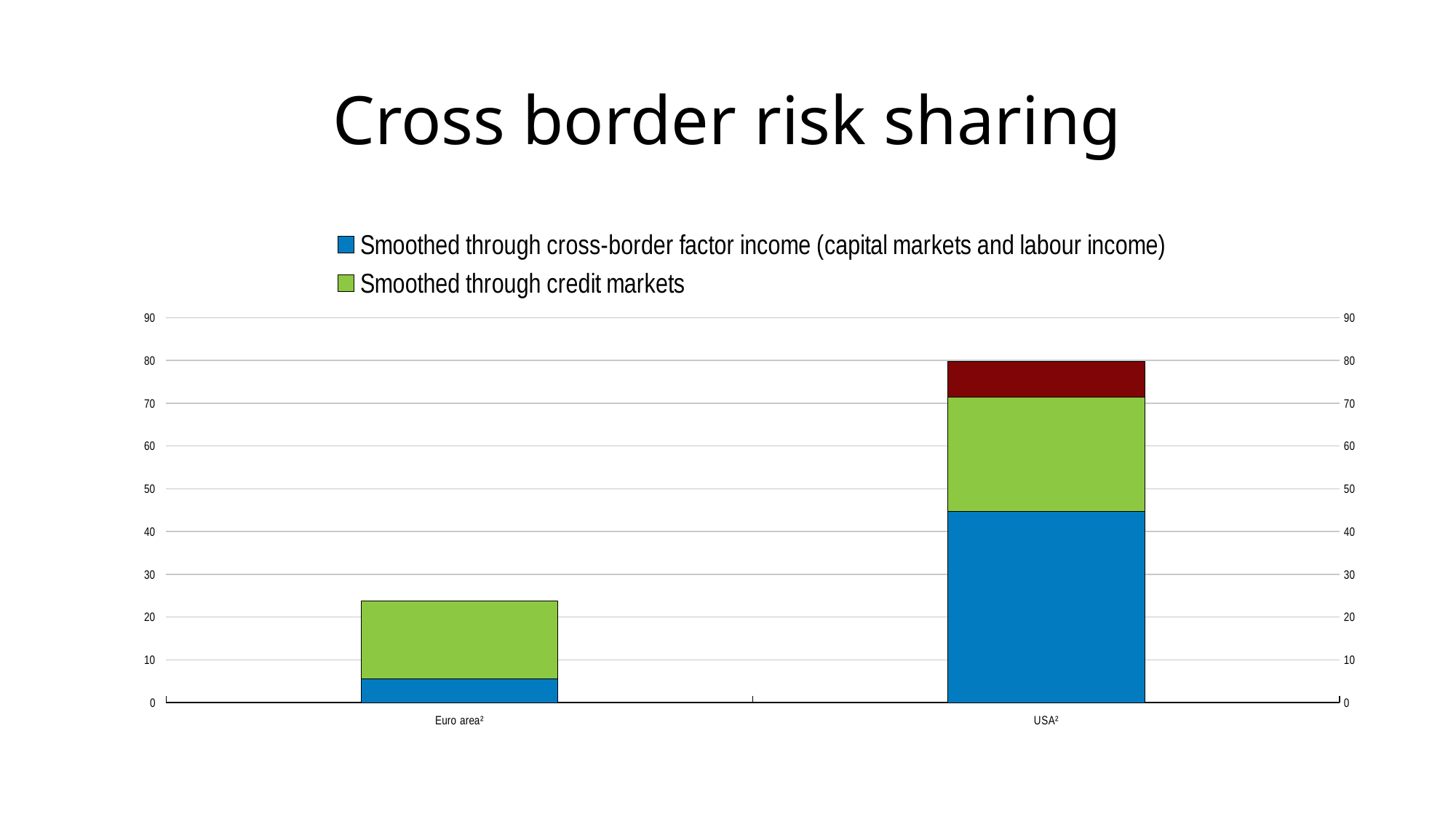
Which category has the larger 'Smoothed through credit markets' segment, Euro area² or USA²? USA² Is the 'Smoothed through cross-border factor income' segment for Euro area² greater or less than 10? less Which category has the taller stacked bar, Euro area² or USA²? USA² Which colour represents 'Smoothed through credit markets' in the legend? Green How many series does the legend list? 2 Is the total height of the USA² bar greater or less than 70? greater What is the title of the slide? Cross border risk sharing Which category has the shorter stacked bar? Euro area² Is the 'Smoothed through cross-border factor income' segment for USA² greater or less than 40? greater What kind of chart is shown on the slide? Stacked bar chart How many categories are shown on the x axis of the chart? 2